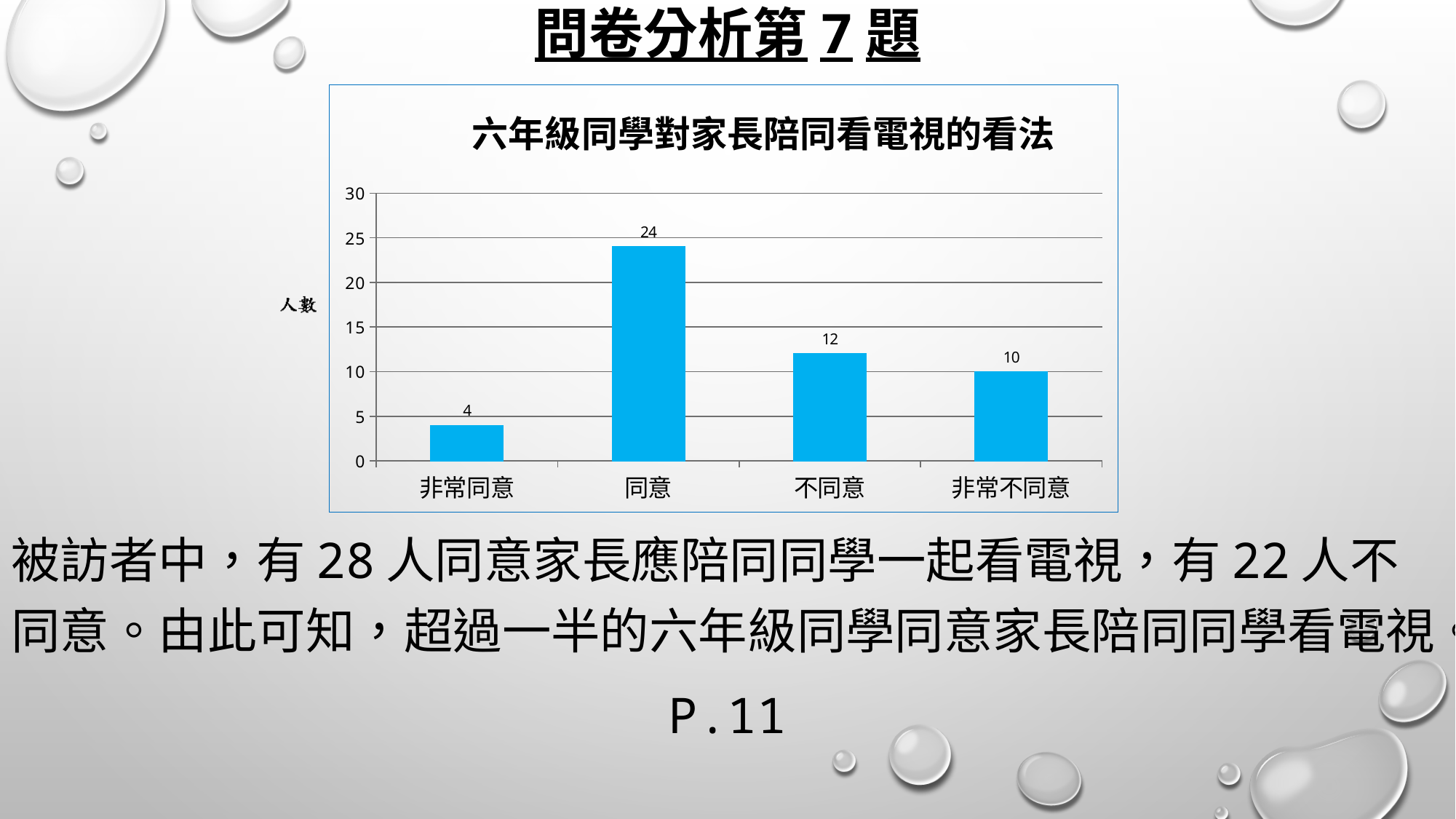
What is the value for 非常同意? 4 What kind of chart is shown? bar chart Which category has the lowest value? 非常同意 Which category has the highest value? 同意 How many categories are shown on the x axis? 4 What is the value for 非常不同意? 10 What is the value for 同意? 24 What is the value for 不同意? 12 What is the title of the chart? 六年級同學對家長陪同看電視的看法 Which is larger, the value for 不同意 or the value for 非常不同意? 不同意 Is the value for 同意 greater or less than 20? greater What is the difference between the values for 同意 and 不同意? 12